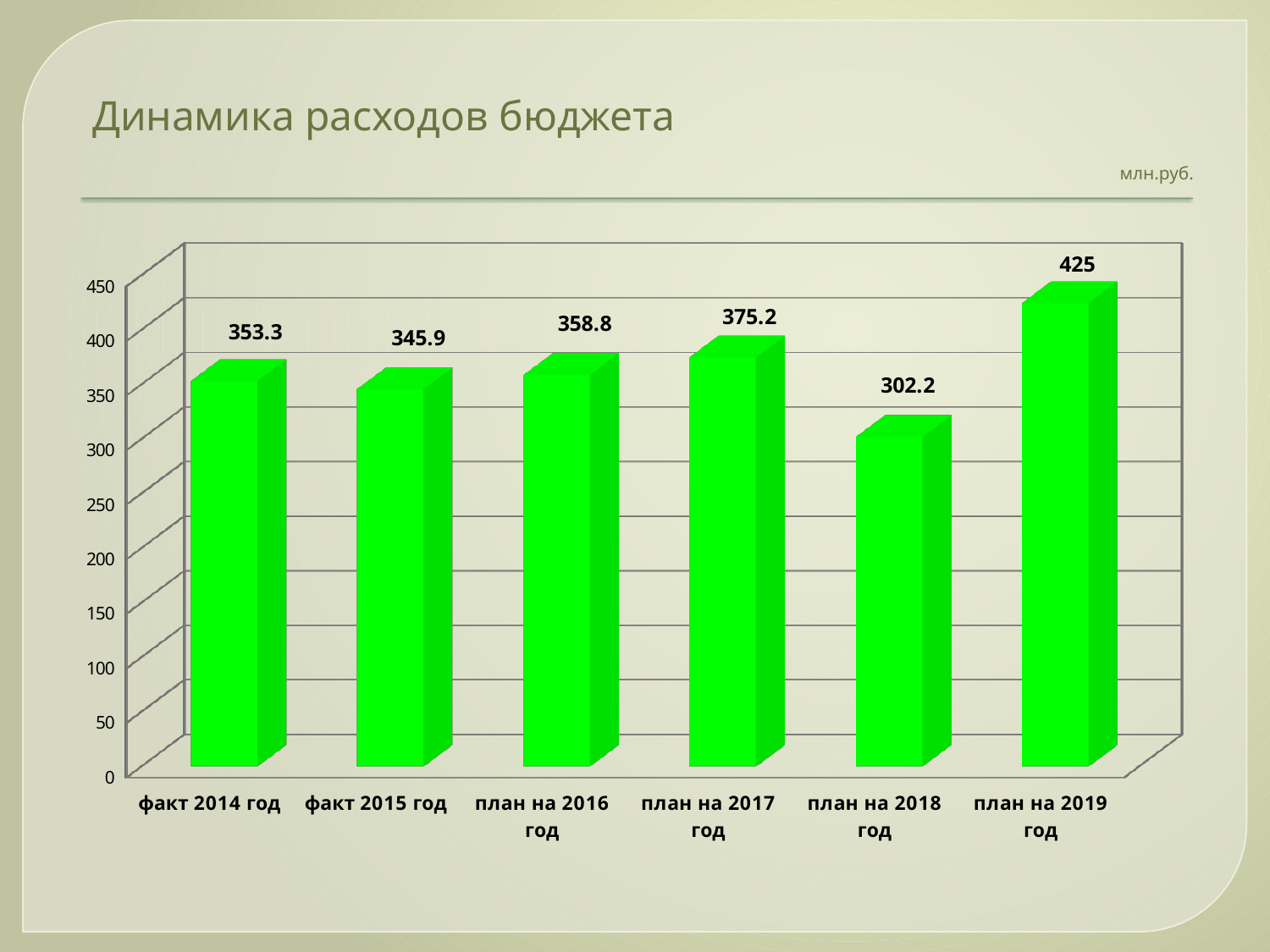
What is the title of the slide? Динамика расходов бюджета What is the value for план на 2018 год? 302.2 How many categories are shown on the x axis? 6 Which is larger, the value for план на 2017 год or the value for план на 2016 год? план на 2017 год Which category has the highest value? план на 2019 год What is the difference between the values for план на 2019 год and план на 2018 год? 122.8 What is the difference between the values for факт 2014 год and факт 2015 год? 7.4 What kind of chart is shown on the slide? bar chart Is the value for план на 2018 год greater or less than 350? less Which category has the lowest value? план на 2018 год What is the value for план на 2019 год? 425 What is the value for факт 2014 год? 353.3